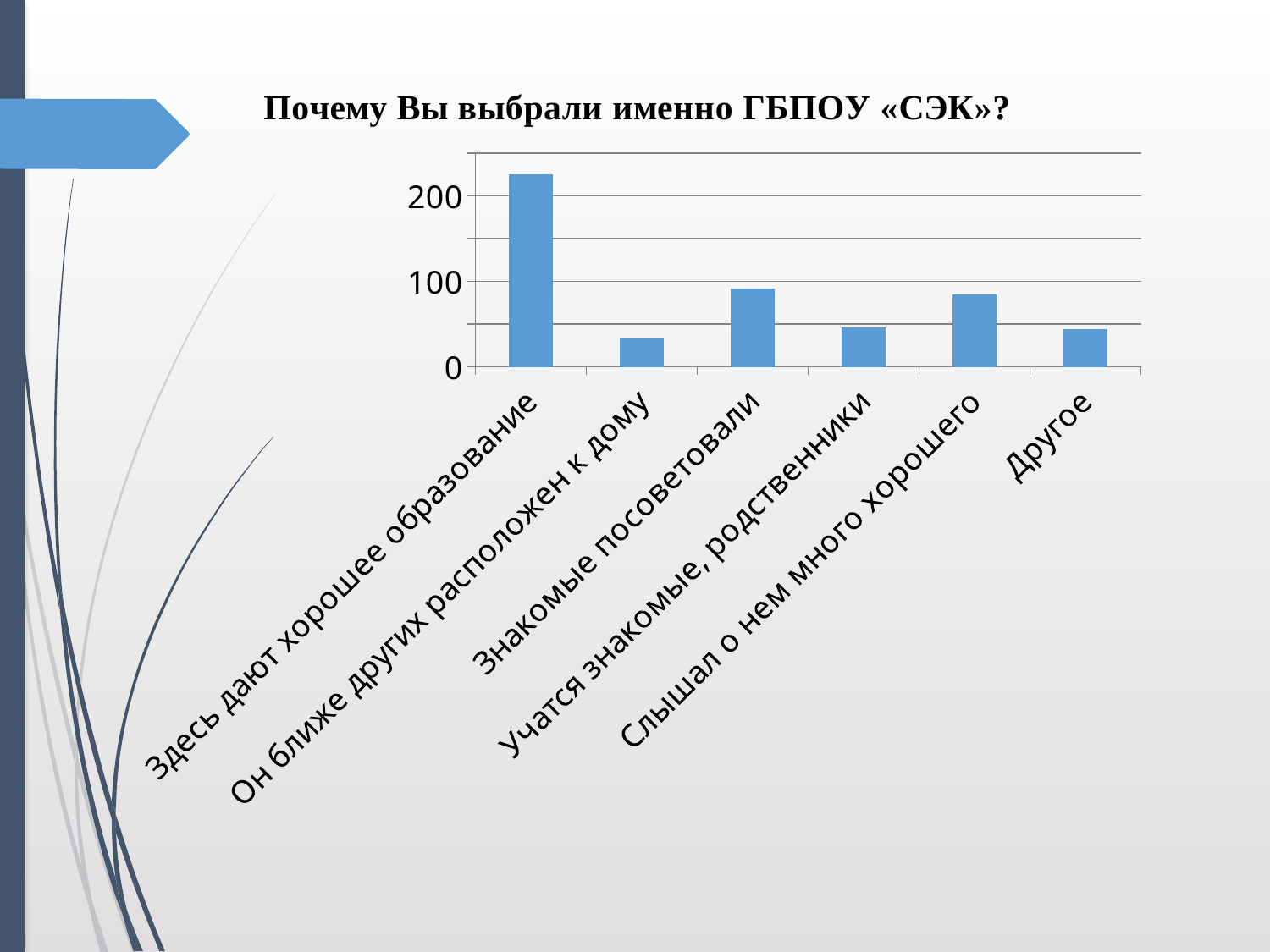
Is the value for "Слышал о нем много хорошего" greater or less than 100? less Which is larger: the value for "Слышал о нем много хорошего" or the value for "Другое"? Слышал о нем много хорошего Which is larger: the value for "Знакомые посоветовали" or the value for "Он ближе других расположен к дому"? Знакомые посоветовали How many categories are shown on the x axis of the chart? 6 Is the value for "Знакомые посоветовали" greater or less than 100? less Which is larger: the value for "Здесь дают хорошее образование" or the value for "Учатся знакомые, родственники"? Здесь дают хорошее образование Is the value for "Здесь дают хорошее образование" greater or less than 200? greater What kind of chart is shown on the slide? bar chart Which category has the highest value in the chart? Здесь дают хорошее образование What is the title of the chart on the slide? Почему Вы выбрали именно ГБПОУ «СЭК»?